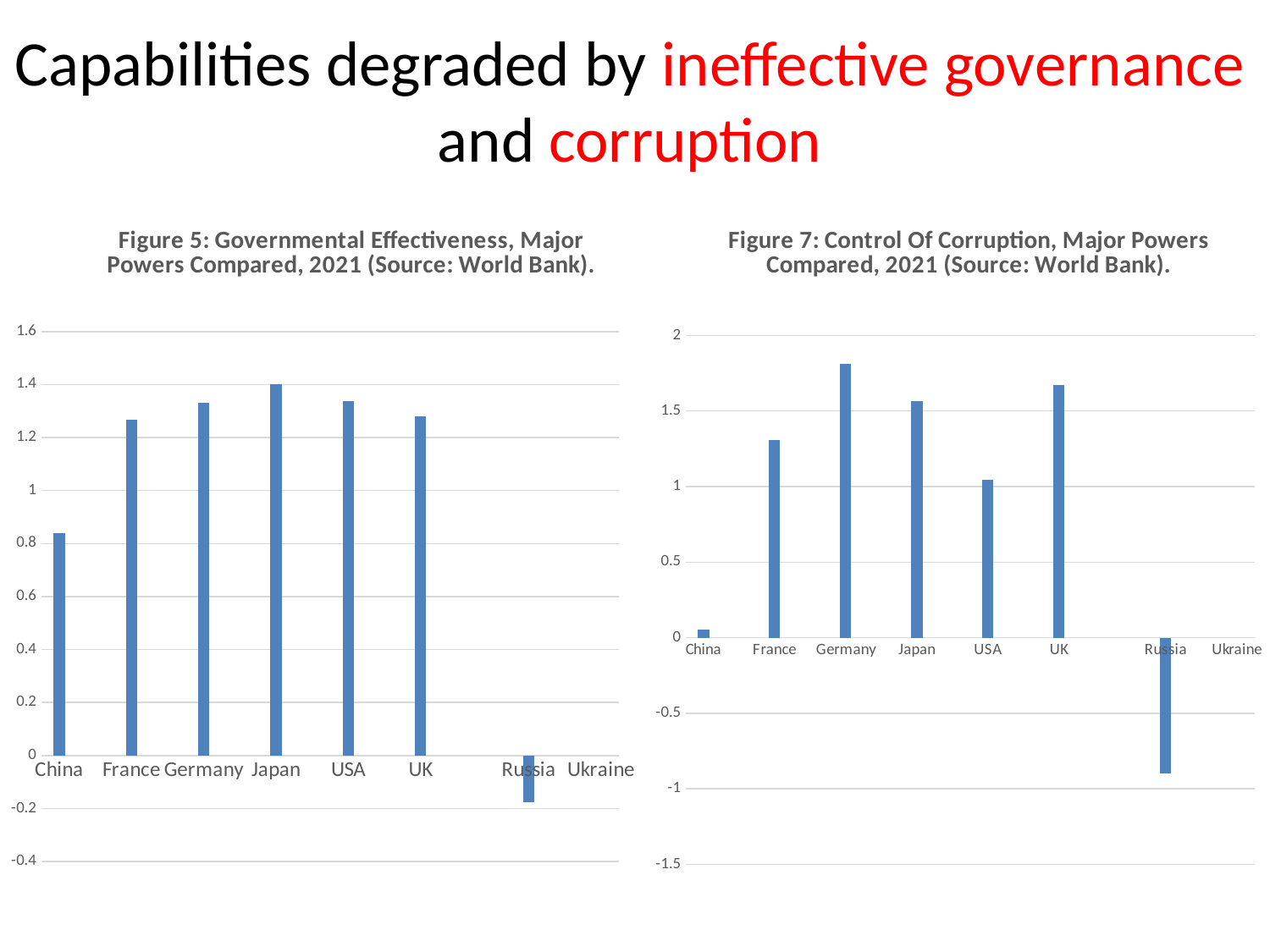
In Figure 7: Control Of Corruption, is the value for UK greater or less than 1.5? greater In Figure 5: Governmental Effectiveness, which country has the lowest value? Russia In Figure 5: Governmental Effectiveness, is the value for China greater or less than 1? less In Figure 5: Governmental Effectiveness, is the value for France greater or less than 1.2? greater According to the chart titles, what is the source of the data in both charts? World Bank In Figure 7: Control Of Corruption, which country has the highest value? Germany What kind of chart is Figure 5: Governmental Effectiveness? Bar chart In Figure 5: Governmental Effectiveness, which is larger, the value for Japan or the value for China? Japan In Figure 5: Governmental Effectiveness, which country has the highest value? Japan In Figure 7: Control Of Corruption, which country has the lowest value? Russia How many countries are listed on the x axis of Figure 5: Governmental Effectiveness? 8